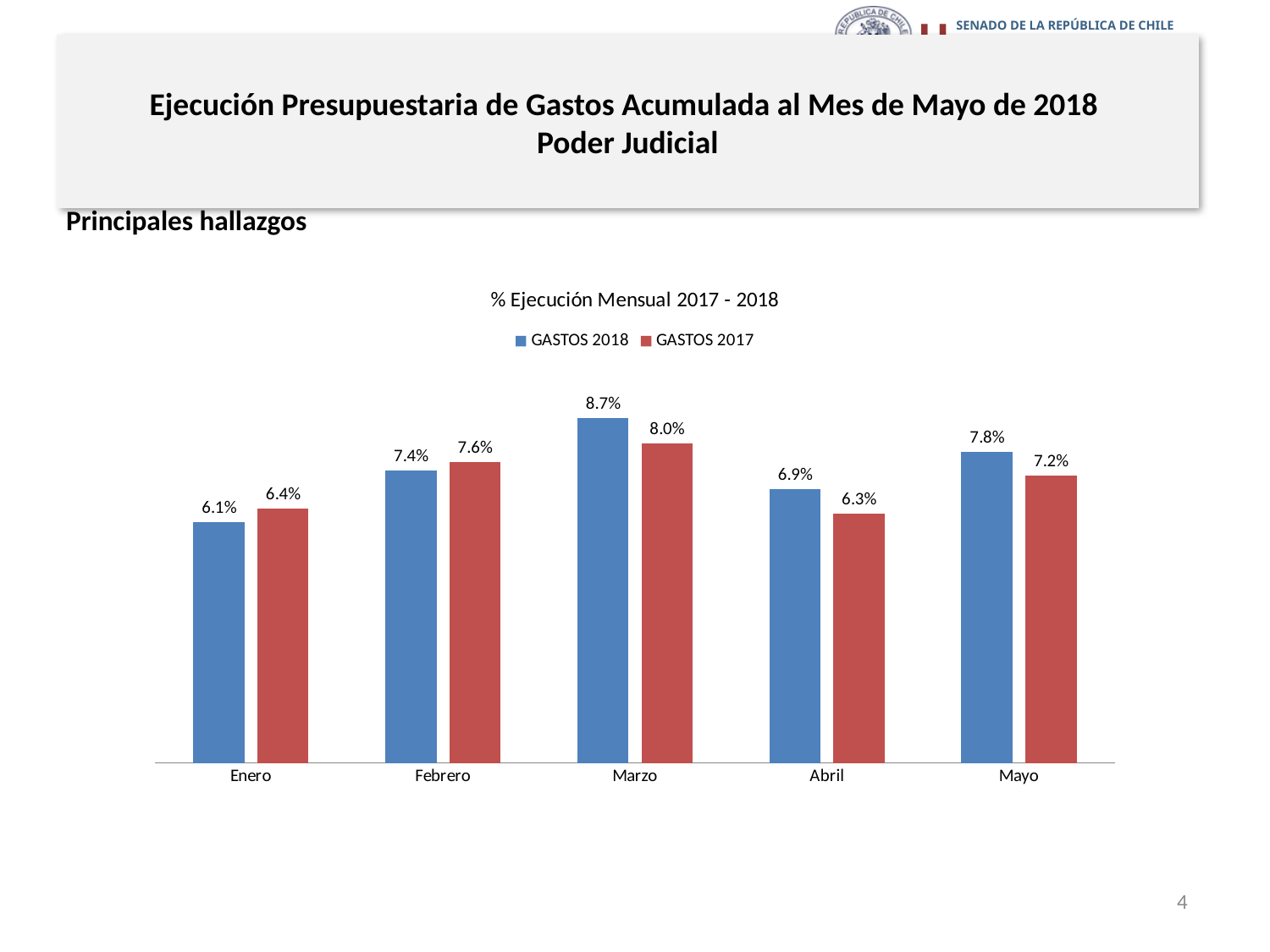
What kind of chart is shown? Bar chart What is the difference between GASTOS 2018 and GASTOS 2017 in Abril? 0.6% How many series does the legend list? 2 What is the title of the chart? % Ejecución Mensual 2017 - 2018 Which is larger in Febrero, GASTOS 2018 or GASTOS 2017? GASTOS 2017 What is the value for GASTOS 2017 in Enero? 6.4% What is the difference between GASTOS 2018 in Marzo and GASTOS 2018 in Febrero? 1.3% Which month has the lowest value for GASTOS 2018? Enero Which month has the highest value for GASTOS 2017? Marzo What is the value for GASTOS 2018 in Marzo? 8.7% What is the value for GASTOS 2018 in Mayo? 7.8% How many months are shown on the x axis? 5